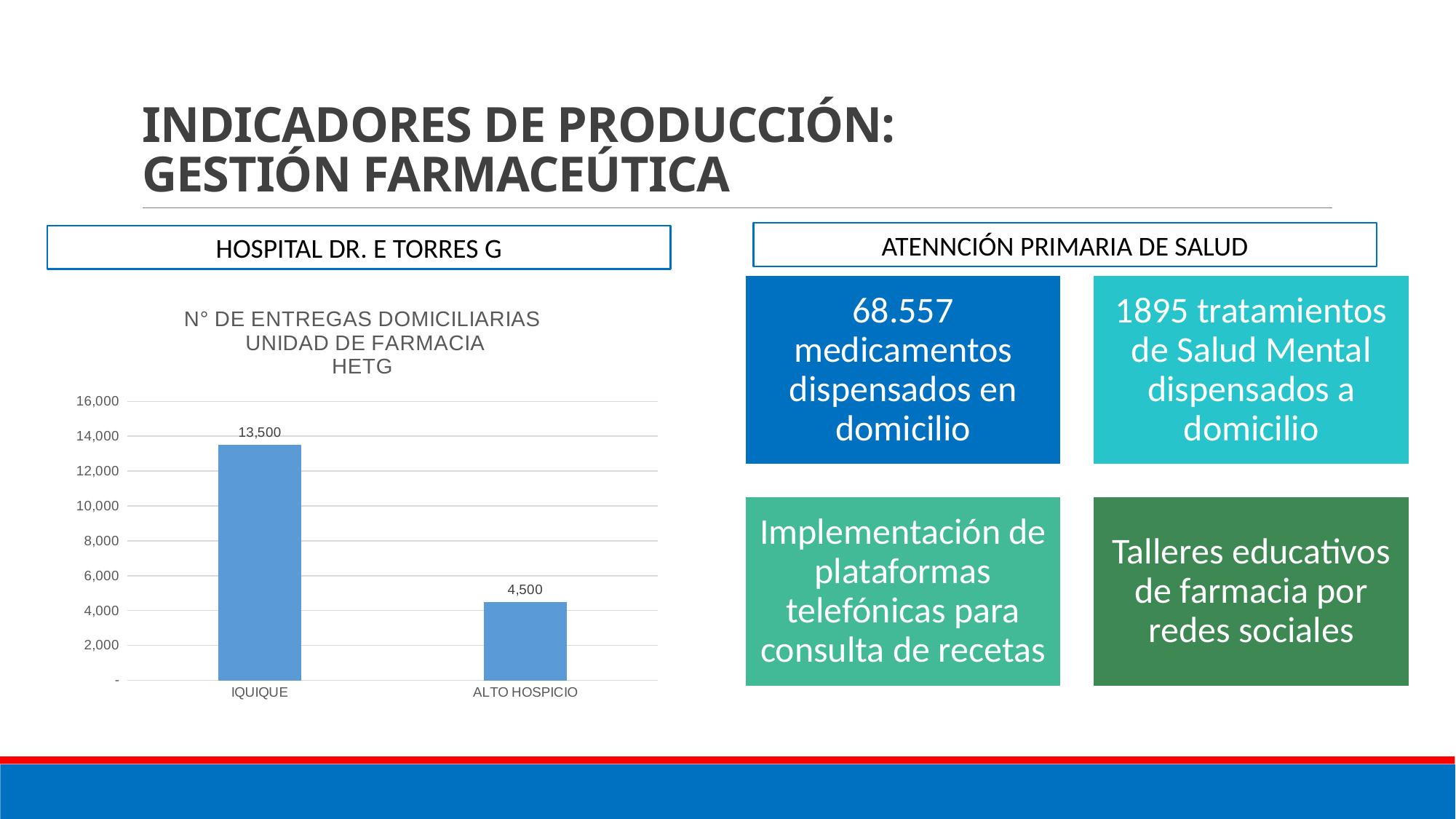
What is the difference between the values for IQUIQUE and ALTO HOSPICIO? 9,000 Which category has the highest value? IQUIQUE What is the highest value shown on the chart's vertical axis? 16,000 What kind of chart is shown on the slide? bar chart Which category has the lowest value? ALTO HOSPICIO What is the value for IQUIQUE? 13,500 Which is larger, the value for IQUIQUE or the value for ALTO HOSPICIO? IQUIQUE Is the value for IQUIQUE greater or less than 12,000? greater How many categories are shown in the chart? 2 Is the value for ALTO HOSPICIO greater or less than 6,000? less What is the title of the chart? N° DE ENTREGAS DOMICILIARIAS UNIDAD DE FARMACIA HETG What is the value for ALTO HOSPICIO? 4,500